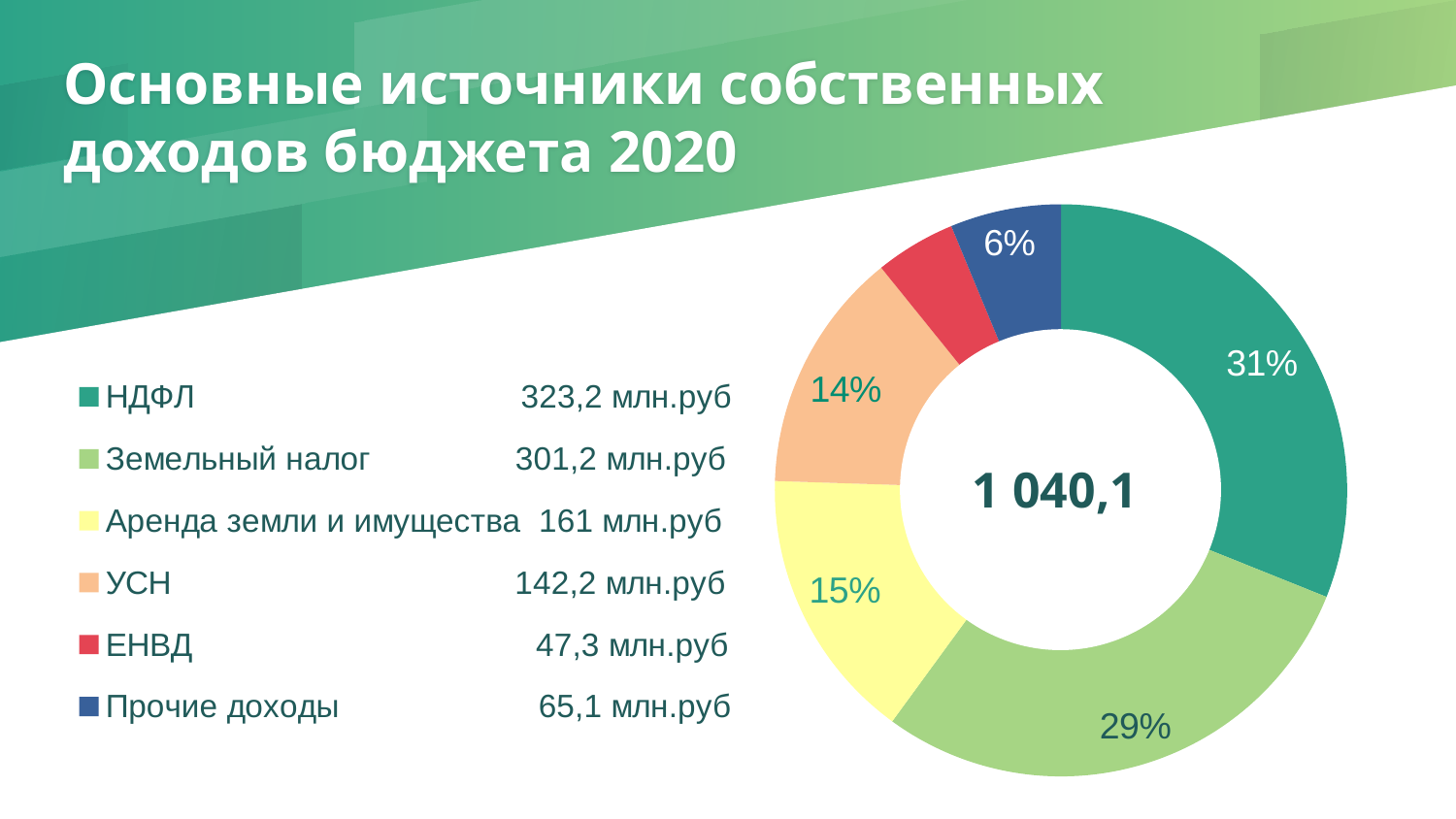
What is the value for НДФЛ? 323,2 млн.руб What is the value for Земельный налог? 301,2 млн.руб Which category has the lowest value? ЕНВД What share of the pie does Прочие доходы represent? 6% What total is shown in the centre of the chart? 1 040,1 What is the difference between the values for НДФЛ and Земельный налог? 22 млн.руб Which category has the highest value? НДФЛ What kind of chart is shown on the slide? pie chart (donut) What share of the pie does Земельный налог represent? 29% How many categories does the legend list? 6 What is the value for ЕНВД? 47,3 млн.руб What is the value for УСН? 142,2 млн.руб